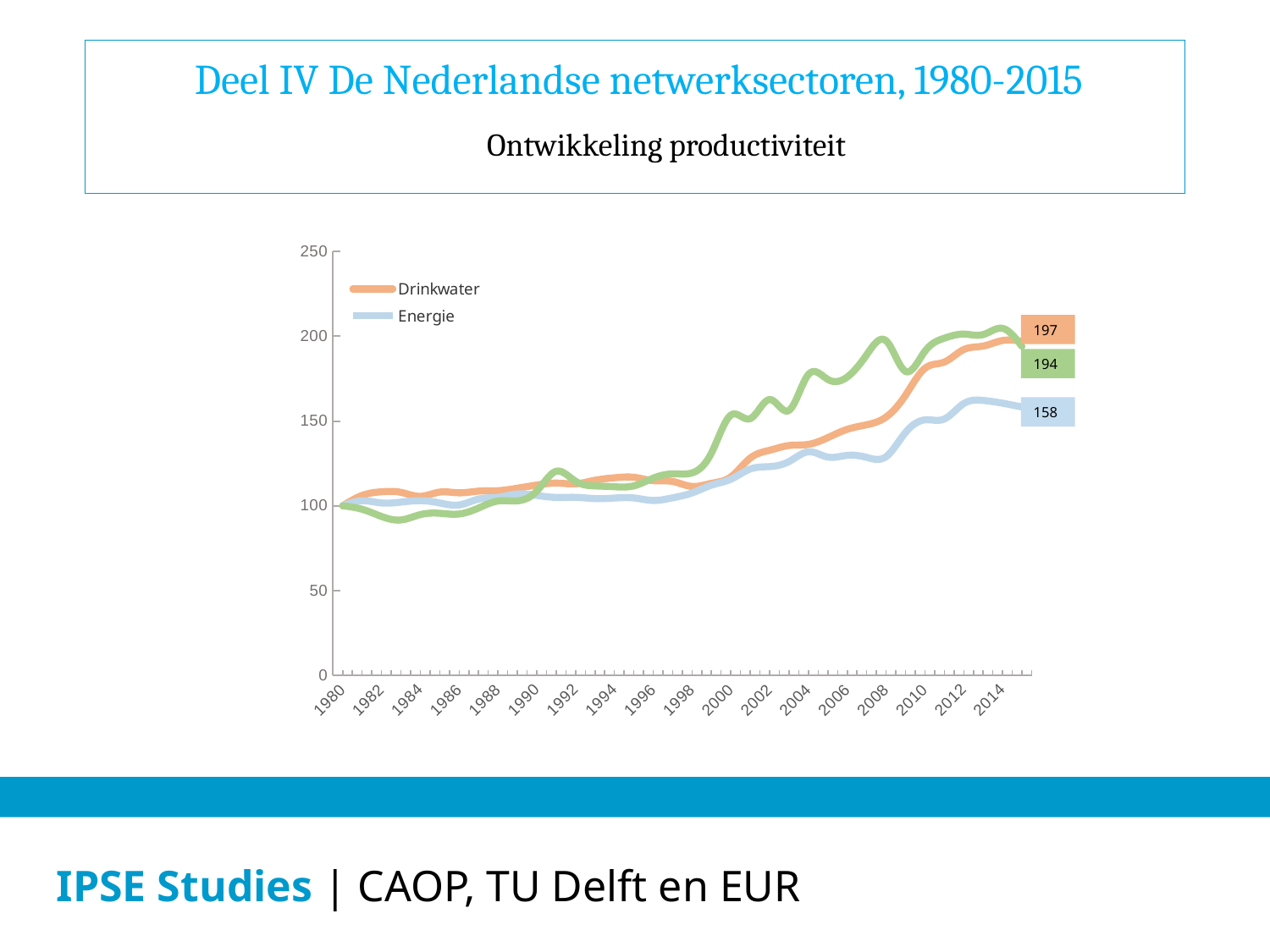
What is the final labelled value of the green line? 194 Do the lines generally rise or fall from 1980 to 2015? rise What is the final labelled value of the Energie line? 158 Is the value of the Energie line in 2014 greater or less than 150? greater Which line has the lowest labelled end value? Energie What is the final labelled value of the Drinkwater line? 197 How many series does the legend list? 2 Which has a larger final labelled value, Drinkwater or Energie? Drinkwater What kind of chart is shown on the slide? line chart Which line has the highest labelled end value? Drinkwater Is the value of the Drinkwater line in 2000 greater or less than 150? less What is the difference between the final labelled values of Drinkwater and Energie? 39